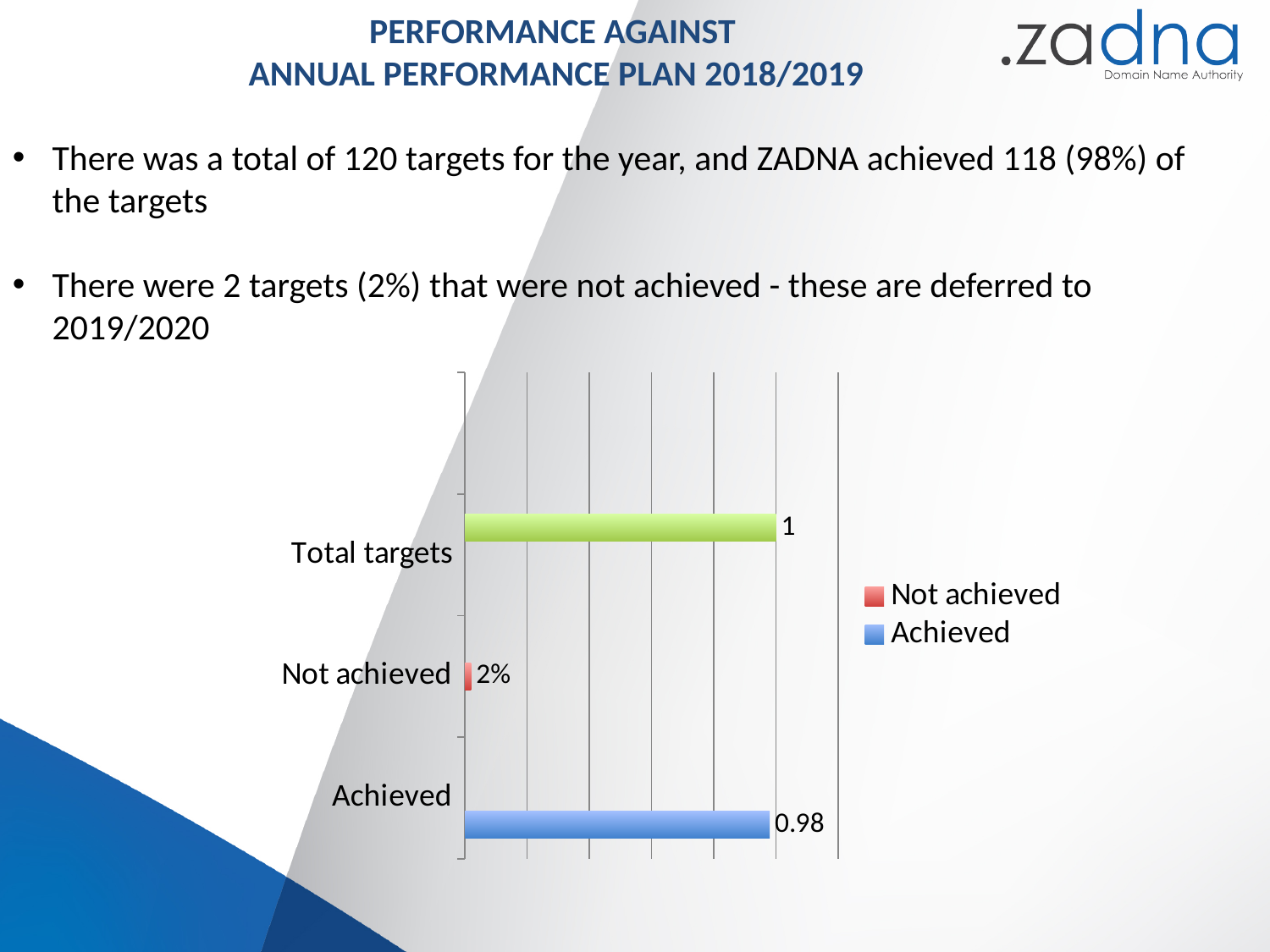
What kind of chart is shown on the slide? bar chart Which category has the longest bar? Total targets What value is shown for Achieved? 0.98 What is the difference between the value for Total targets and the value for Achieved? 0.02 What entries are listed in the legend? Not achieved, Achieved What colour is the Achieved bar? blue Which category has the shortest bar? Not achieved How many categories are plotted on the chart? 3 How many series does the legend list? 2 What value is shown for Not achieved? 2% What value is shown for Total targets? 1 Which is larger, the bar for Achieved or the bar for Not achieved? Achieved